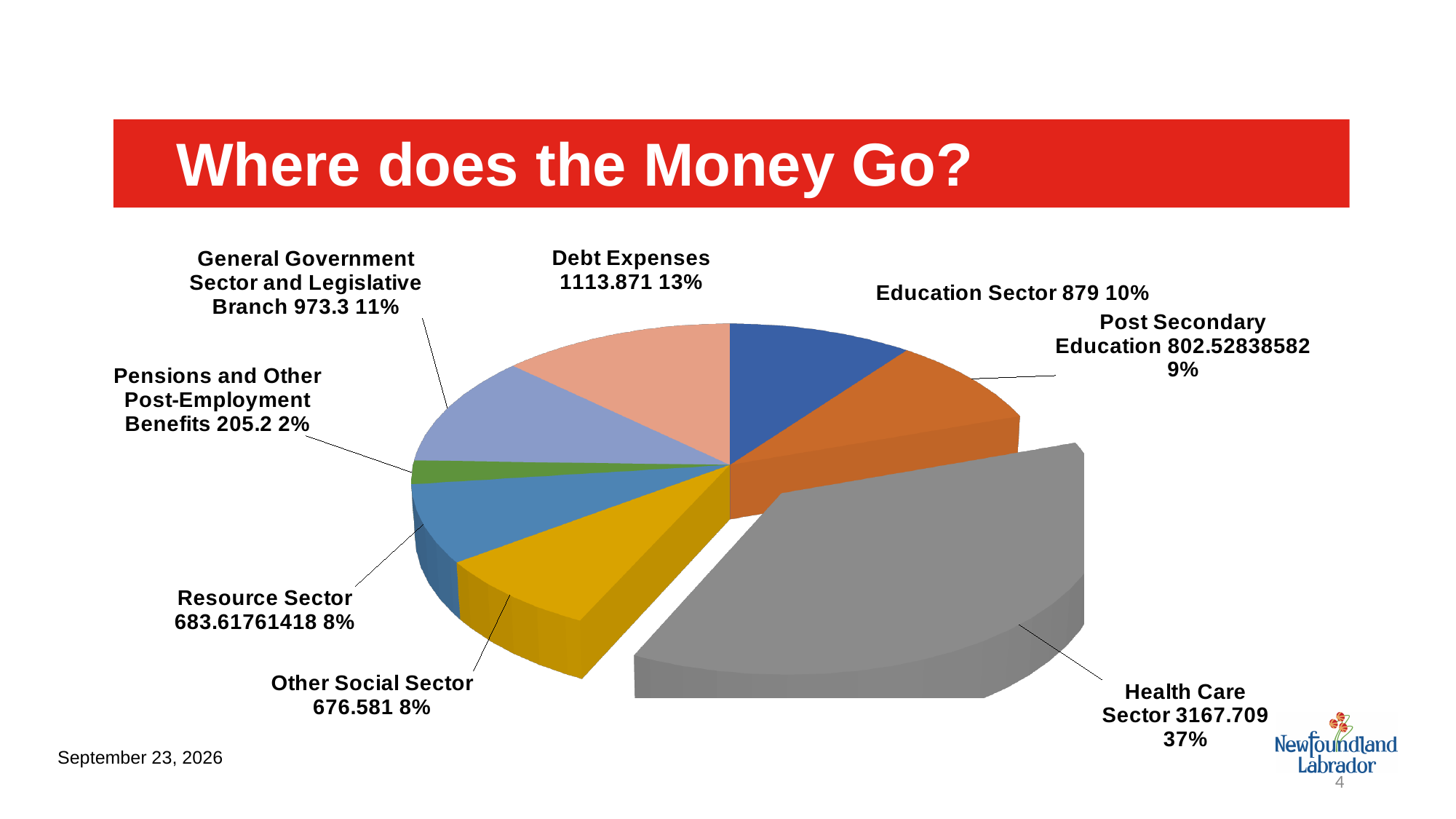
Which sector has the smallest slice of the pie? Pensions and Other Post-Employment Benefits What percentage share of the pie does the General Government Sector and Legislative Branch have? 11% What is the value shown for the Health Care Sector? 3167.709 What is the value shown for Debt Expenses? 1113.871 Which sector has the largest slice of the pie? Health Care Sector What is the value shown for the Education Sector? 879 Which is larger, the value for Debt Expenses or the value for the General Government Sector and Legislative Branch? Debt Expenses What kind of chart is shown on the slide? pie chart How many slices does the pie chart have? 8 What is the difference between the value for Debt Expenses and the value for the Education Sector? 234.871 What percentage share of the pie does the Health Care Sector have? 37% What is the value shown for Pensions and Other Post-Employment Benefits? 205.2